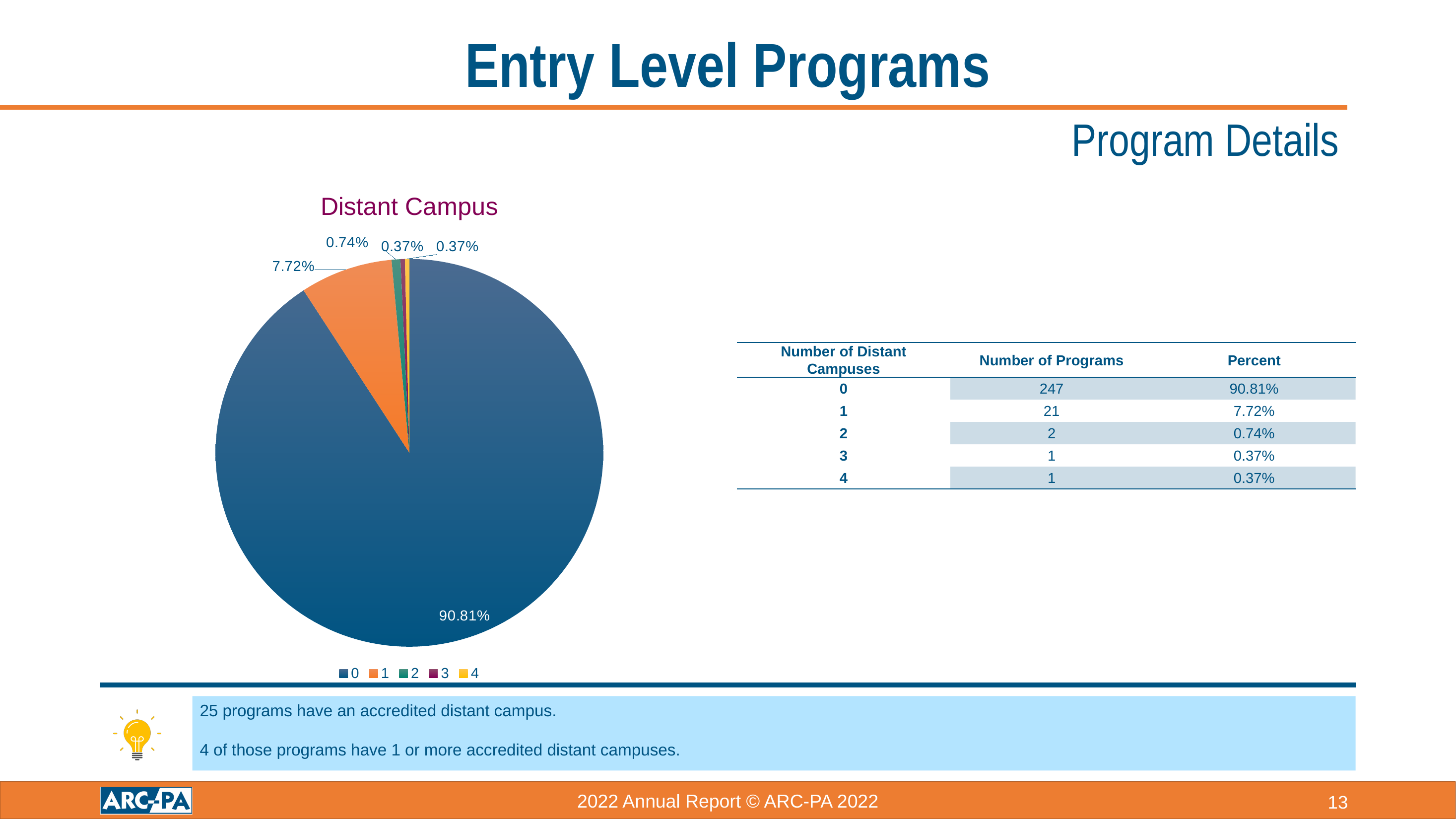
What share of the pie does the slice for 0 distant campuses represent? 90.81% What share of the pie does the slice for 2 distant campuses represent? 0.74% How many slices does the pie chart have? 5 What share of the pie does the slice for 1 distant campus represent? 7.72% What colour is the slice for 1 distant campus? orange How many entries does the legend list? 5 Which category has the largest slice of the pie? 0 What type of chart is shown on the slide? pie chart What is the difference in percentage points between the slice for 0 and the slice for 1 distant campus? 83.09 Which is larger, the slice for 1 distant campus or the slice for 2 distant campuses? 1 What is the difference in percentage points between the slice for 1 and the slice for 2 distant campuses? 6.98 What is the title of the chart? Distant Campus